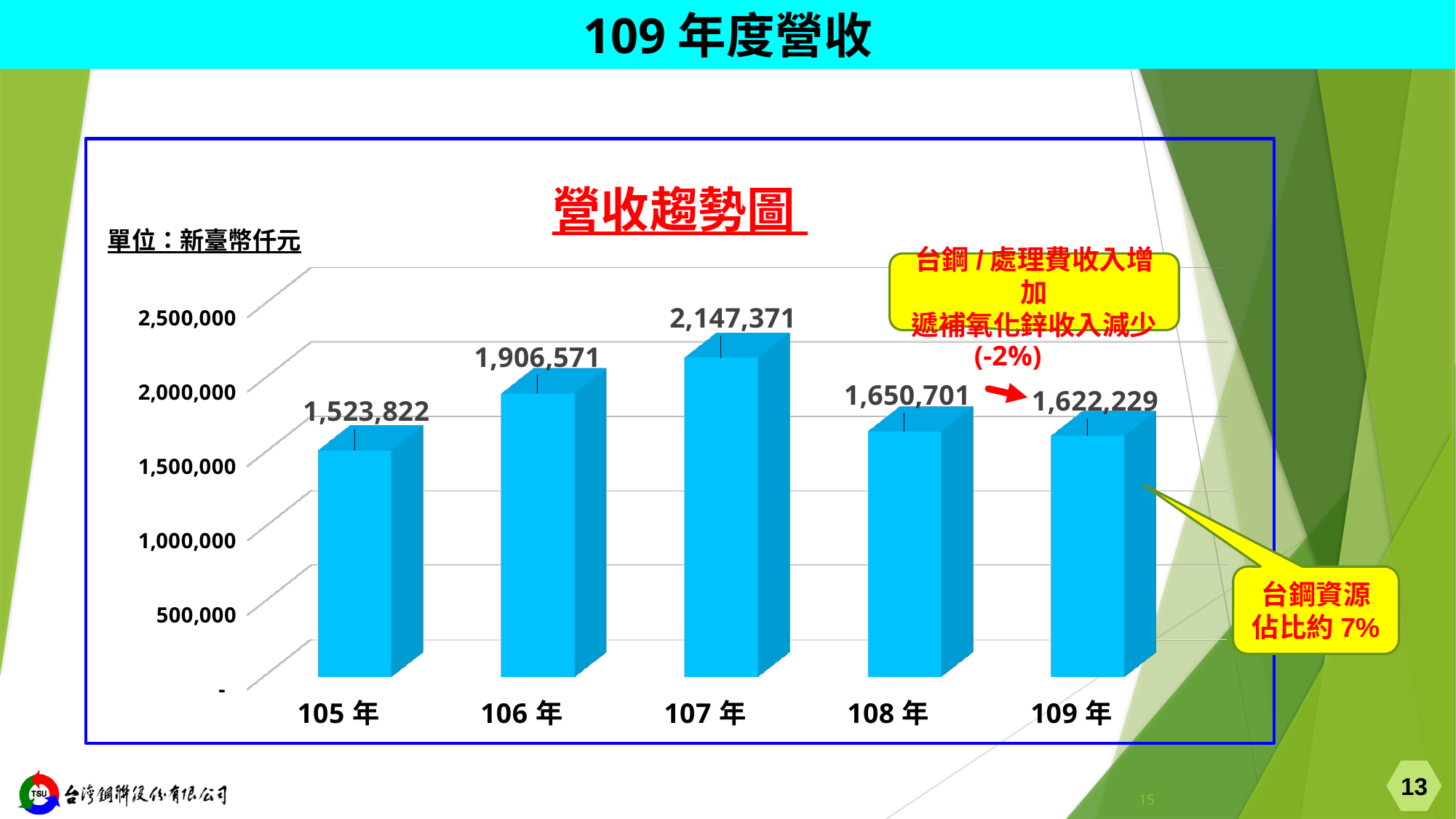
Which year has the highest revenue in the chart? 107 年 What is the difference between the revenue for 108 年 and 109 年? 28,472 What is the revenue value shown for 105 年? 1,523,822 What is the difference between the revenue for 107 年 and 106 年? 240,800 Is the value for 107 年 greater or less than 2,000,000? greater What is the title of the chart? 營收趨勢圖 What is the revenue value shown for 109 年? 1,622,229 Which year has the lowest revenue in the chart? 105 年 How many years (categories) are shown in the chart? 5 Which is larger, the revenue for 106 年 or 108 年? 106 年 What is the revenue value shown for 107 年? 2,147,371 What kind of chart is shown on the slide? bar chart